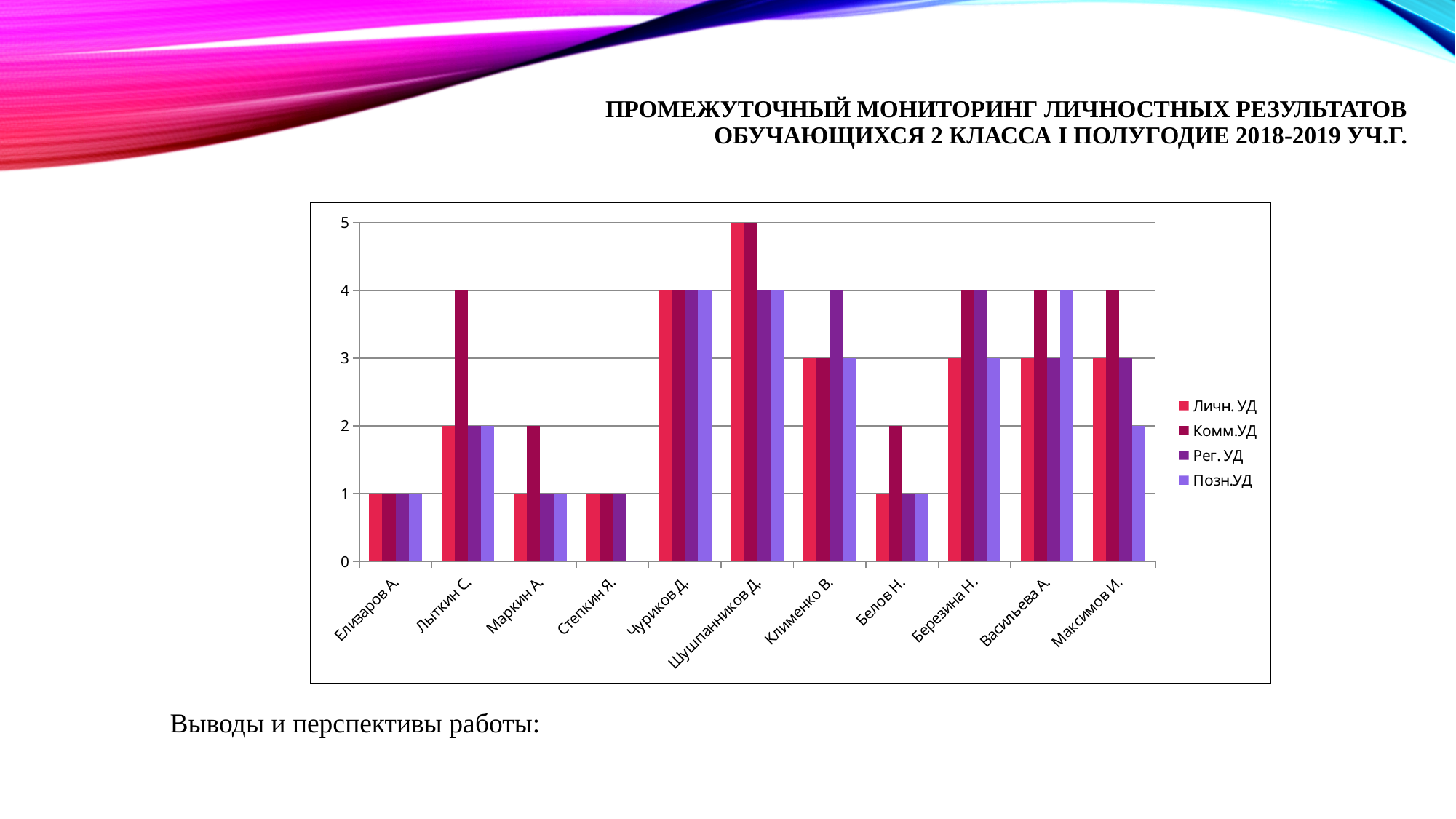
What is the difference between the Комм.УД value and the Личн. УД value for Лыткин С.? 2 What is the Рег. УД value for Клименко В.? 4 What is the Комм.УД value for Лыткин С.? 4 How many students (categories) are shown on the x axis? 11 What kind of chart is shown on the slide? bar chart Which is larger for Белов Н.: the Комм.УД value or the Рег. УД value? Комм.УД Which series is shown in the lightest purple colour in the legend? Позн.УД Is the Личн. УД value for Чуриков Д. greater or less than 3? greater What is the Личн. УД value for Шушпанников Д.? 5 Which student has the highest Комм.УД value? Шушпанников Д. What is the Позн.УД value for Максимов И.? 2 How many series does the legend list? 4